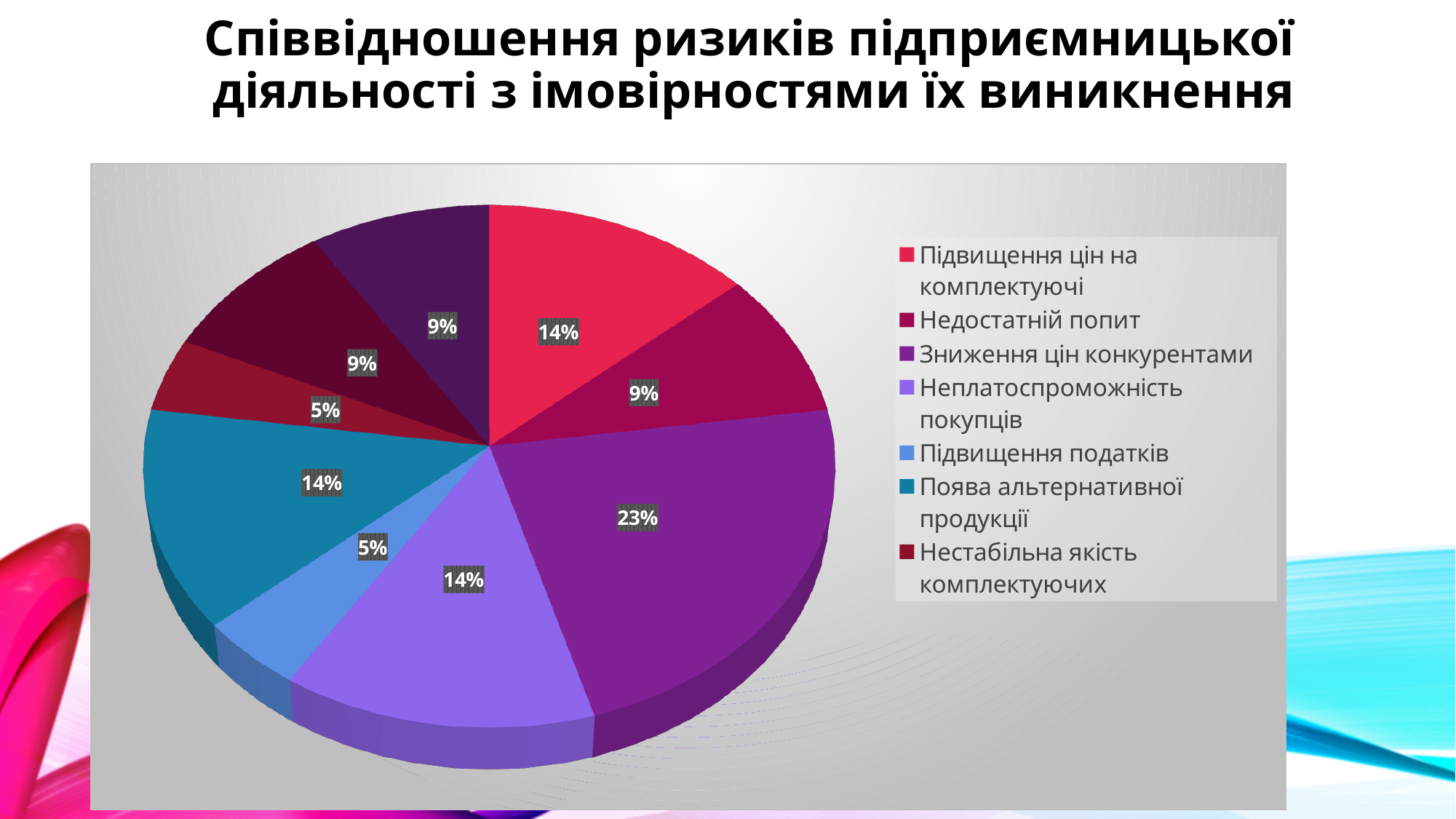
How many entries does the legend list? 7 How many slices does the pie chart have? 9 What is the value shown for "Недостатній попит"? 9% What is the value shown for "Поява альтернативної продукції"? 14% What share of the pie does "Зниження цін конкурентами" have? 23% By how many percentage points does "Зниження цін конкурентами" exceed "Неплатоспроможність покупців"? 9 percentage points What colour is the slice for "Поява альтернативної продукції"? Teal Which category has the largest slice of the pie? Зниження цін конкурентами What is the value shown for "Підвищення податків"? 5% What kind of chart is shown on the slide? Pie chart What is the value shown for "Підвищення цін на комплектуючі"? 14% Which is larger: the slice for "Недостатній попит" or the slice for "Підвищення податків"? Недостатній попит